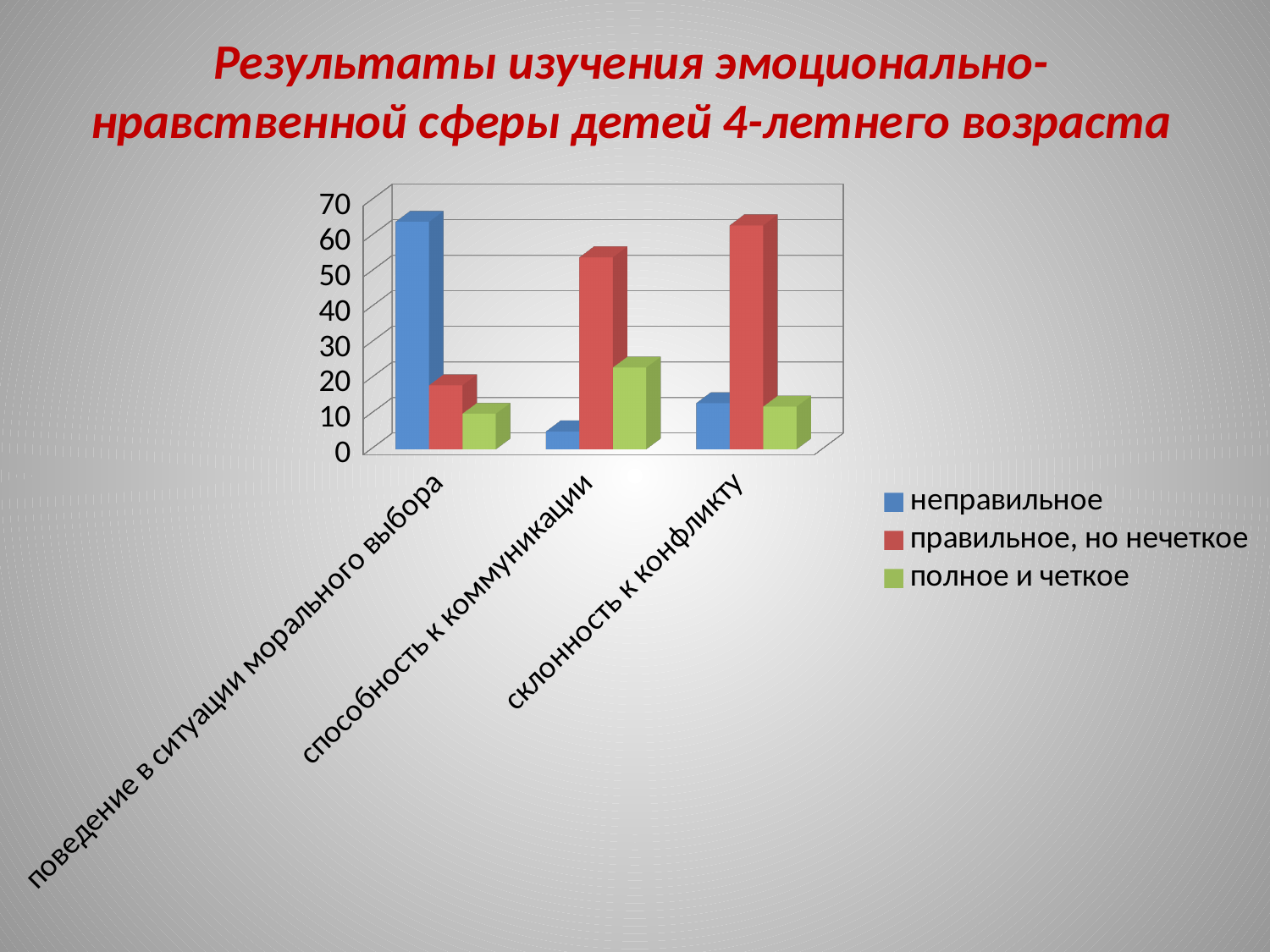
Which series has the lowest value for the category 'поведение в ситуации морального выбора'? полное и четкое Is the value of 'неправильное' for 'способность к коммуникации' greater or less than 10? less Which is larger: the value of 'полное и четкое' for 'способность к коммуникации' or for 'поведение в ситуации морального выбора'? способность к коммуникации How many series does the legend list? 3 Is the value of 'неправильное' for 'поведение в ситуации морального выбора' greater or less than 50? greater Is the value of 'правильное, но нечеткое' for 'склонность к конфликту' greater or less than 50? greater How many categories are shown on the x axis of the chart? 3 Which series has the highest value for the category 'поведение в ситуации морального выбора'? неправильное Which colour represents the series 'полное и четкое' in the legend? green What kind of chart is shown on the slide? bar chart Which series has the highest value for the category 'способность к коммуникации'? правильное, но нечеткое Which series has the lowest value for the category 'способность к коммуникации'? неправильное